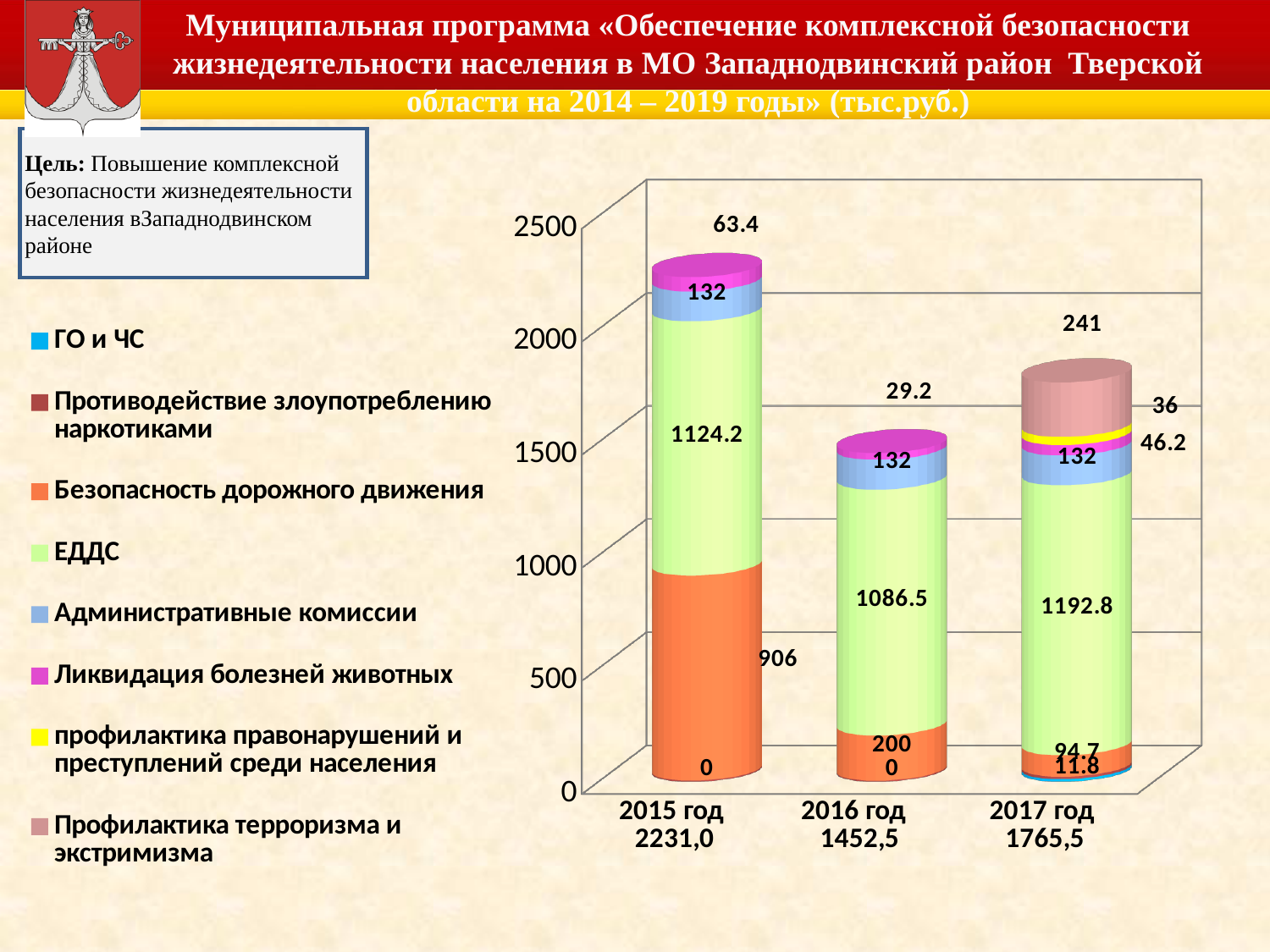
What kind of chart is shown on the slide? stacked bar chart What is the value for Профилактика терроризма и экстримизма in 2017 год? 241 What is the difference between the ЕДДС values for 2017 год and 2016 год? 106.3 Which is larger: Безопасность дорожного движения in 2015 год or in 2017 год? 2015 год What is the value for Безопасность дорожного движения in 2016 год? 200 How many years (categories) are shown on the x axis? 3 How many series does the legend list? 8 Which year has the lowest total? 2016 год Which year has the highest total? 2015 год What is the total for 2017 год as printed under the axis? 1765,5 What is the value for Ликвидация болезней животных in 2016 год? 29.2 What is the value for ЕДДС in 2015 год? 1124.2